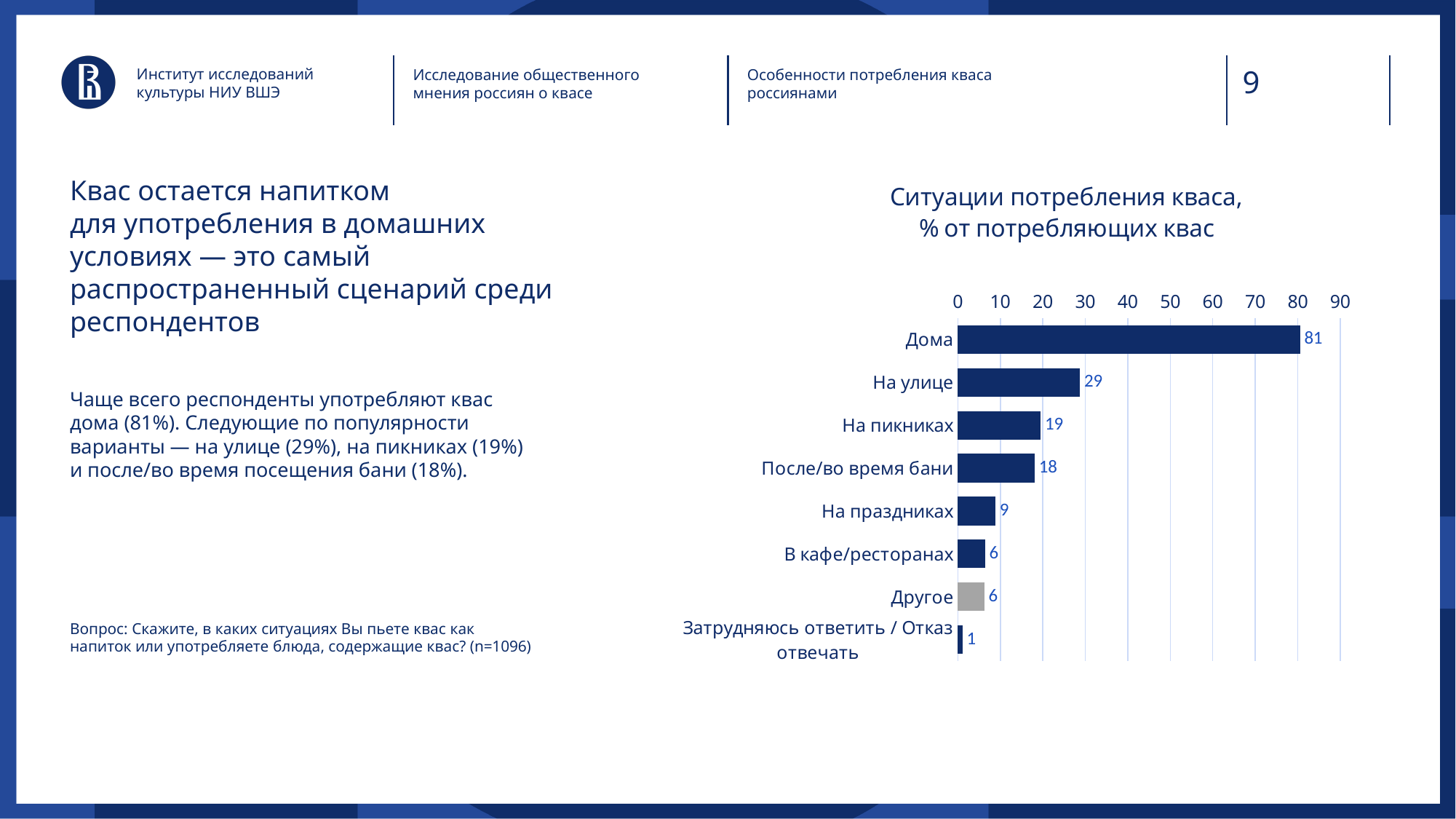
What is the difference between the values for Дома and На улице? 52 What is the title of the chart? Ситуации потребления кваса, % от потребляющих квас Is the value for На улице greater or less than 20? greater What kind of chart is shown on the slide? bar chart How many categories are shown in the chart? 8 What is the value for Затрудняюсь ответить / Отказ отвечать? 1 Which category has the highest value? Дома What is the difference between the values for На пикниках and После/во время бани? 1 Which is larger, the value for На праздниках or the value for В кафе/ресторанах? На праздниках Which category has the lowest value? Затрудняюсь ответить / Отказ отвечать What is the value for На пикниках? 19 What is the value for Дома? 81